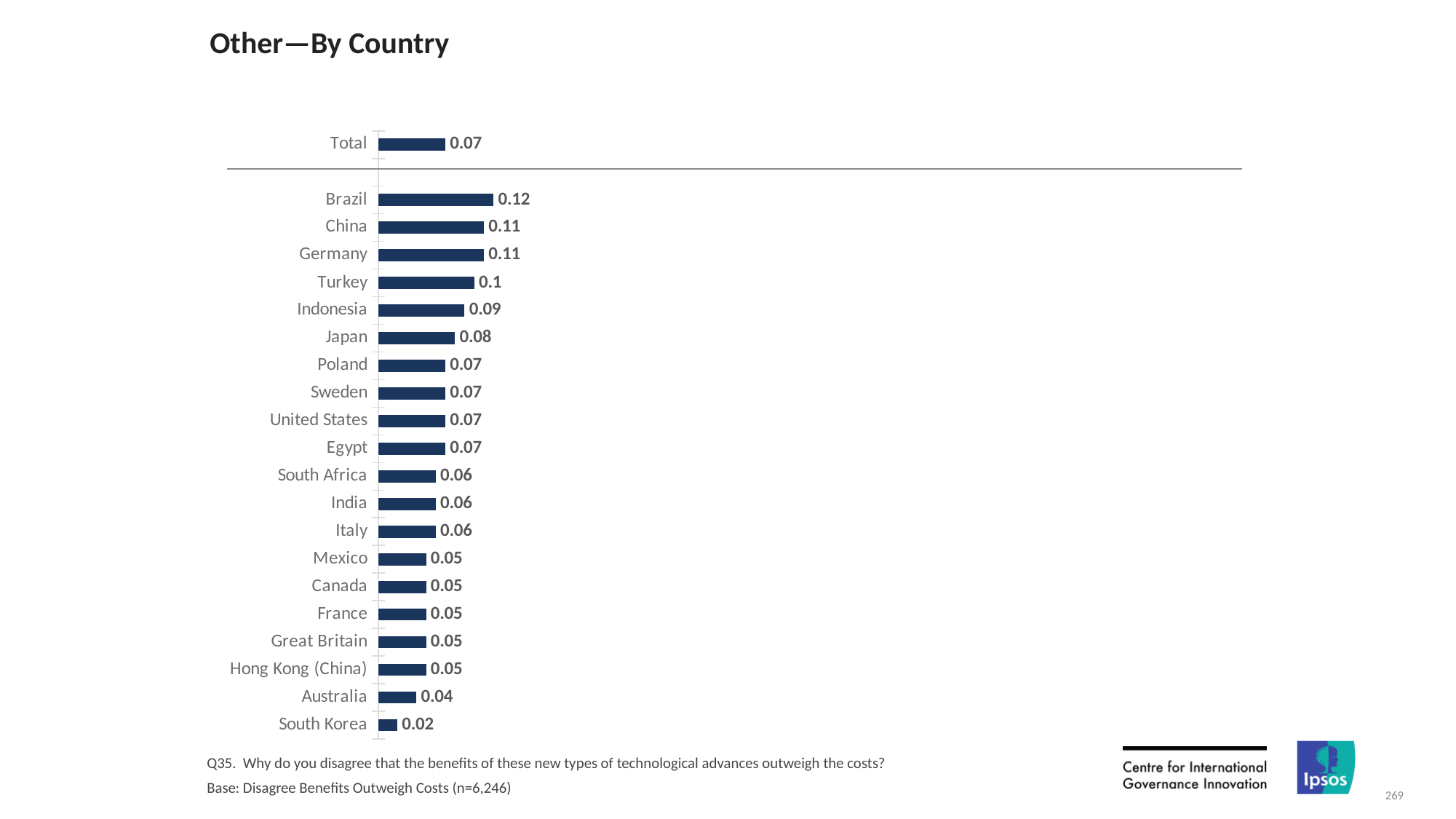
What is the difference between the values for Indonesia and Australia? 0.05 Which has a larger value, Japan or Mexico? Japan What is the title of the slide? Other—By Country What kind of chart is shown on the slide? Bar chart What is the value for Brazil? 0.12 Which country has the highest value? Brazil What is the value for Turkey? 0.1 What is the value for Total? 0.07 What is the difference between the values for Brazil and South Korea? 0.1 What is the value for South Korea? 0.02 Which country has the lowest value? South Korea How many countries are shown in the chart, excluding Total? 19